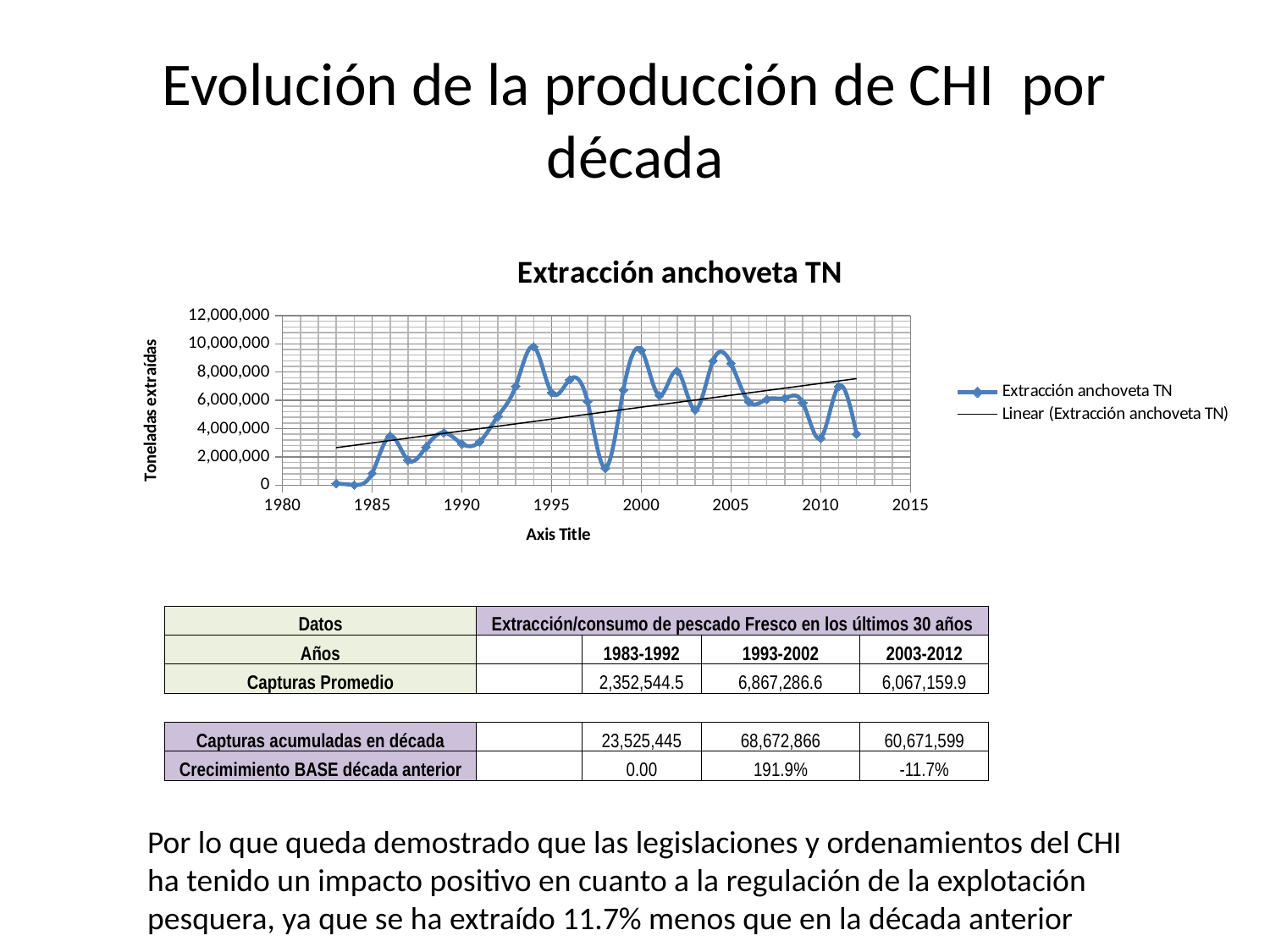
What kind of chart is shown on the slide? line chart Is the value for 1998 greater or less than 2,000,000? less Which of the two is larger: the value for 1994 or the value for 1998? 1994 What is the title of the chart? Extracción anchoveta TN How many entries does the legend of the chart list? 2 Does the linear trendline rise or fall from 1983 to 2012? rises What is the label on the vertical axis of the chart? Toneladas extraídas Is the value for 2005 greater or less than 6,000,000? greater Is the value for 2010 greater or less than 4,000,000? less